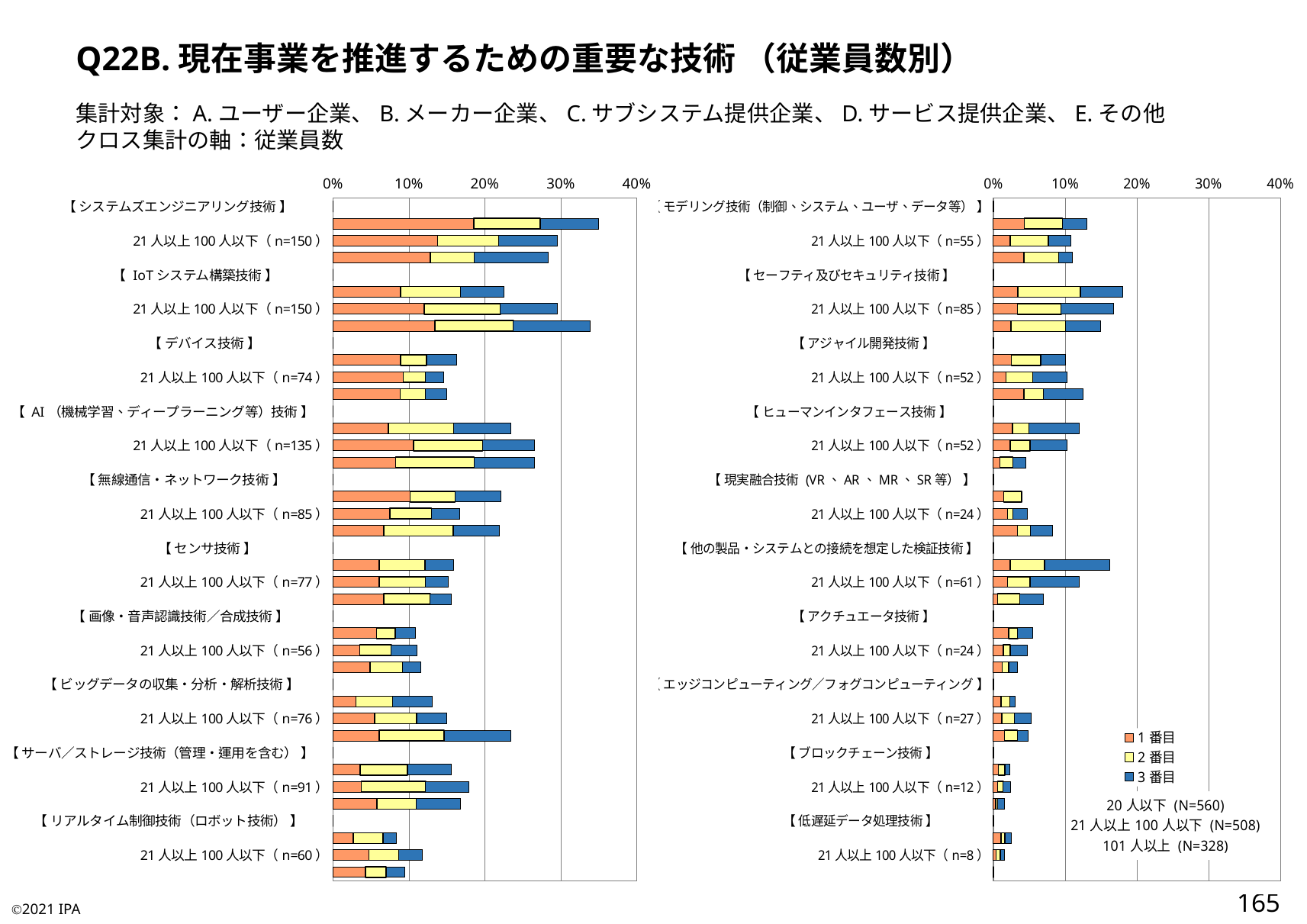
How many series does the legend list for the charts? 3 What is the maximum value shown on the horizontal axis of the left chart? 40% In the right chart, which has the larger total stacked value: the first bar for セーフティ及びセキュリティ技術 or the first bar for 低遅延データ処理技術? セーフティ及びセキュリティ技術 In the right chart, is the total stacked value of the first bar for セーフティ及びセキュリティ技術 greater or less than 10%? greater In the left chart, is the total stacked value of the 21人以上100人以下 (n=74) bar for デバイス技術 greater or less than 20%? less In the left chart, which has the larger total stacked value: the first bar for システムズエンジニアリング技術 or the first bar for デバイス技術? システムズエンジニアリング技術 In the left chart, is the total stacked value of the first bar for リアルタイム制御技術（ロボット技術） greater or less than 10%? less What are the three legend entries shown on the slide? 1番目, 2番目, 3番目 What kind of chart is used on the left side of the slide? Stacked horizontal bar chart How many bars are plotted for each technology group in the charts? 3